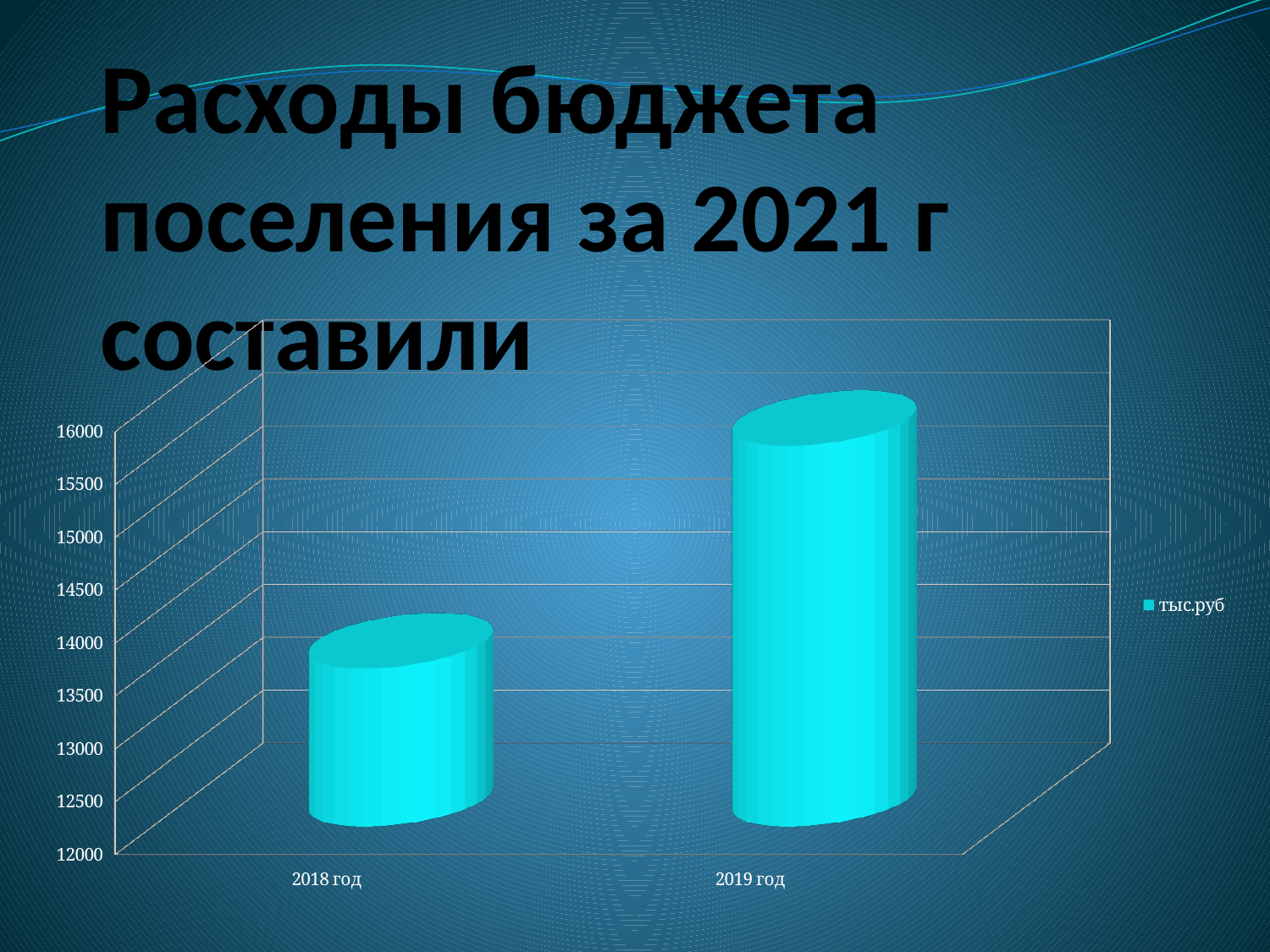
What is the legend entry of the chart? тыс.руб Is the value for 2018 год greater or less than 13000? greater Do the values rise or fall from 2018 год to 2019 год? rise Is the value for 2019 год greater or less than 15000? greater What is the lowest value shown on the vertical axis of the chart? 12000 Which is larger, the value for 2018 год or the value for 2019 год? 2019 год Is the value for 2018 год greater or less than 15000? less How many series does the chart legend list? 1 What kind of chart is shown on the slide? bar chart Which category has the highest value in the chart? 2019 год Which category has the lowest value in the chart? 2018 год How many categories are shown on the x axis of the chart? 2